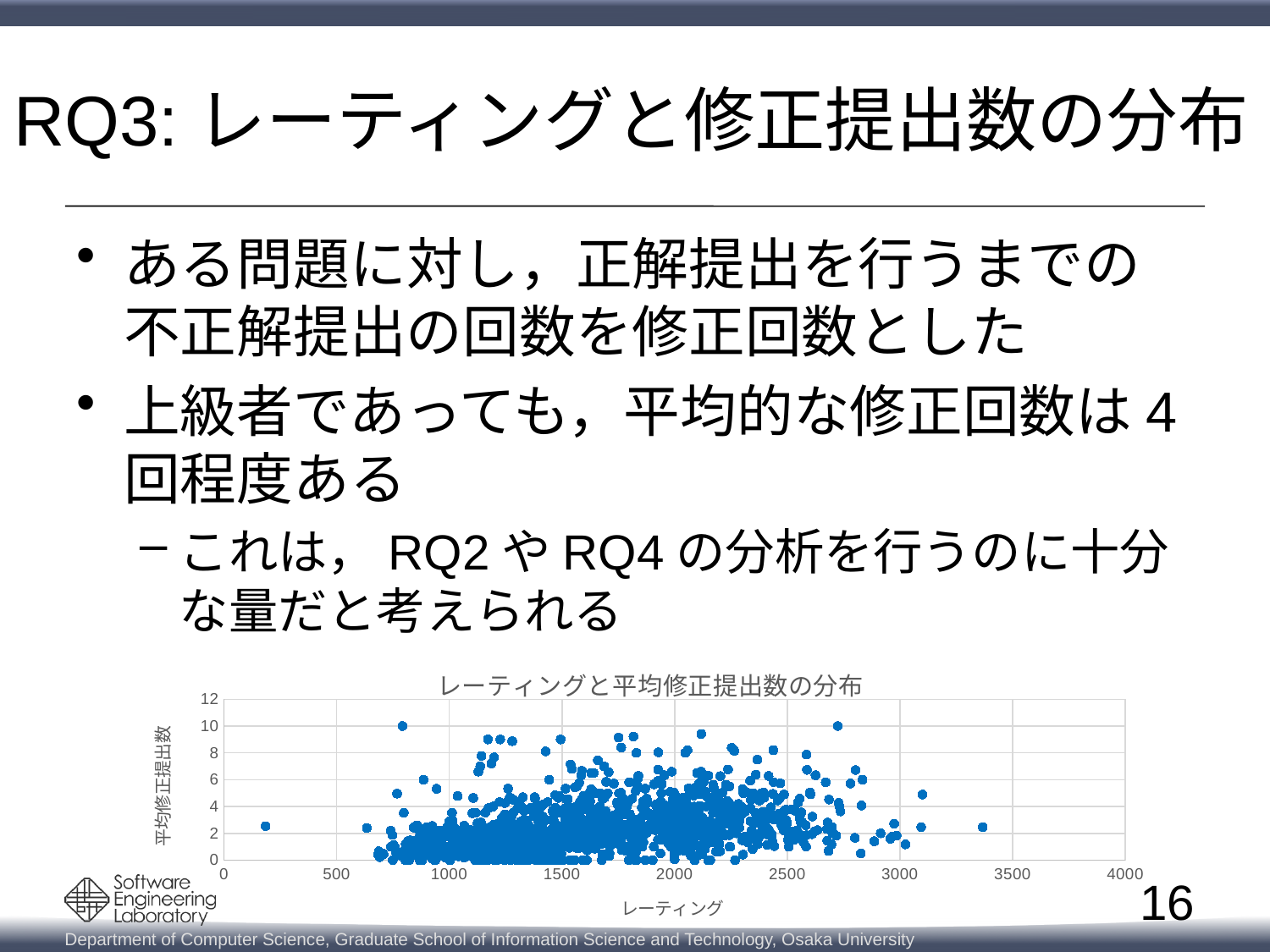
What is the label of the x axis of the chart? レーティング What is the title of the chart? レーティングと平均修正提出数の分布 Is the rating (x value) of the leftmost point in the chart greater or less than 500? less Is the rating (x value) of the rightmost point in the chart greater or less than 3000? greater What is the highest value shown on the y axis of the chart? 12 What kind of chart is shown on the slide? scatter plot What is the highest value shown on the x axis of the chart? 4000 Are any points in the chart plotted above a y value of 12? No